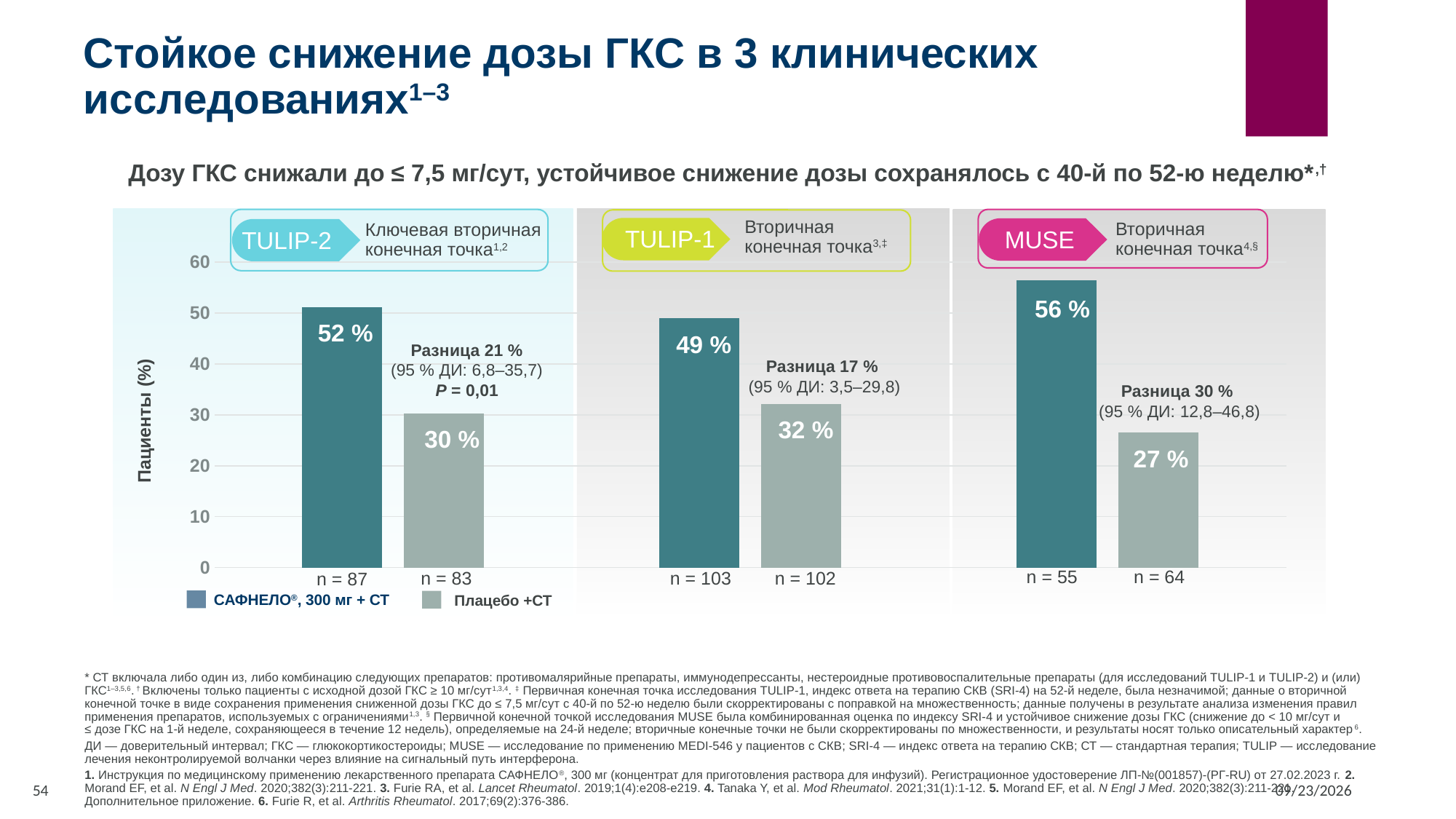
Across the three studies, which study shows the highest value for the САФНЕЛО, 300 мг + СТ group? MUSE What is the difference between the САФНЕЛО, 300 мг + СТ and Плацебо + СТ values in the TULIP-1 study? 17 % What percentage of patients in the TULIP-1 study achieved the endpoint in the Плацебо + СТ group? 32 % What percentage of patients in the MUSE study achieved the endpoint in the Плацебо + СТ group? 27 % Across the three studies, which study shows the lowest value for the Плацебо + СТ group? MUSE What kind of chart is shown on the slide? bar chart Is the value for the Плацебо + СТ group in the TULIP-2 study greater or less than 40? less What percentage of patients in the TULIP-2 study achieved the endpoint in the САФНЕЛО, 300 мг + СТ group? 52 % How many series does the legend list? 2 In the MUSE study, which group has the larger value: САФНЕЛО, 300 мг + СТ or Плацебо + СТ? САФНЕЛО, 300 мг + СТ What is the label of the y axis of the chart? Пациенты (%) How many patients (n) were in the САФНЕЛО, 300 мг + СТ group of the TULIP-1 study? n = 103